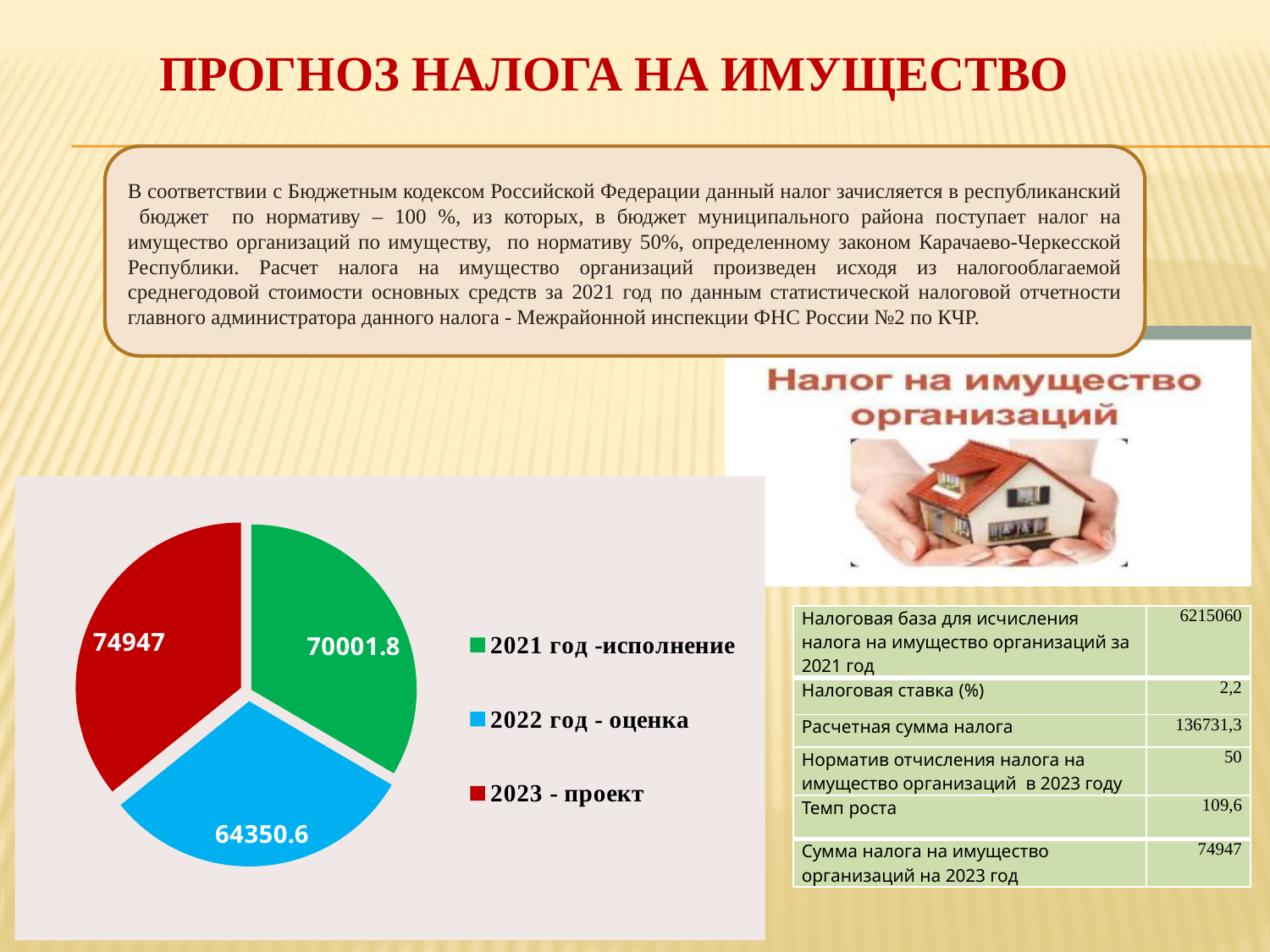
What is the value shown for the "2021 год -исполнение" slice of the pie chart? 70001.8 What is the value shown for the "2023 - проект" slice of the pie chart? 74947 Which category has the smallest slice in the pie chart? 2022 год - оценка What colour is the "2023 - проект" slice in the pie chart? Red Which category has the largest slice in the pie chart? 2023 - проект How many entries does the legend of the pie chart list? 3 What is the value shown for the "2022 год - оценка" slice of the pie chart? 64350.6 What is the difference between the values for "2023 - проект" and "2021 год -исполнение" in the pie chart? 4945.2 How many slices does the pie chart have? 3 What type of chart is shown on the slide? Pie chart What is the difference between the values for "2021 год -исполнение" and "2022 год - оценка" in the pie chart? 5651.2 In the pie chart, which is larger: the value for "2021 год -исполнение" or for "2022 год - оценка"? 2021 год -исполнение